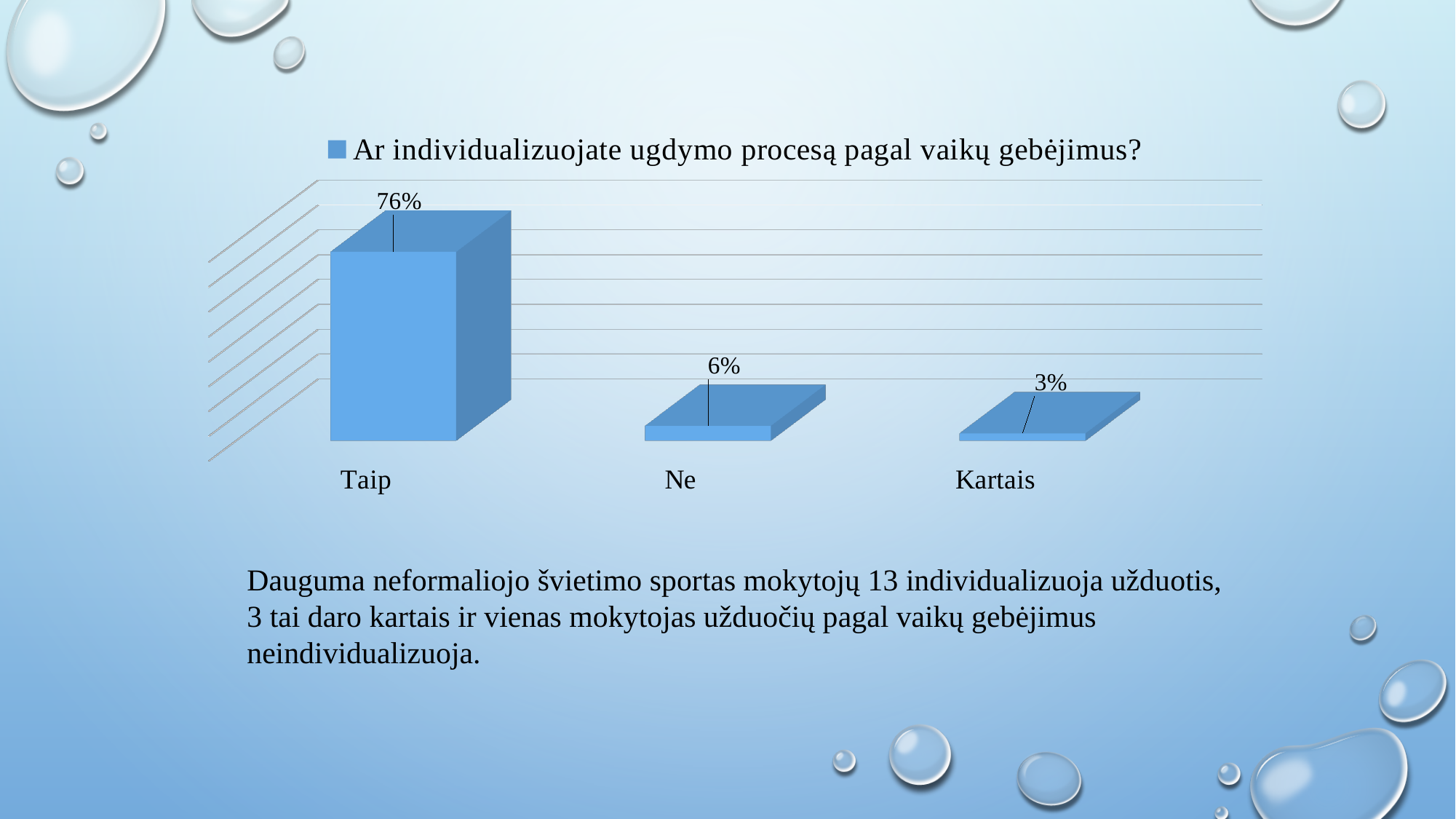
Which is larger, the value for Ne or the value for Kartais? Ne What is the value for Taip? 76% What kind of chart is shown on the slide? bar chart What is the value for Ne? 6% What is the value for Kartais? 3% What is the difference between the values for Taip and Ne? 70% How many series does the legend list? 1 What is the legend entry of the series shown in the chart? Ar individualizuojate ugdymo procesą pagal vaikų gebėjimus? Which category has the lowest value? Kartais What is the difference between the values for Ne and Kartais? 3% How many categories are shown in the chart? 3 Which category has the highest value? Taip